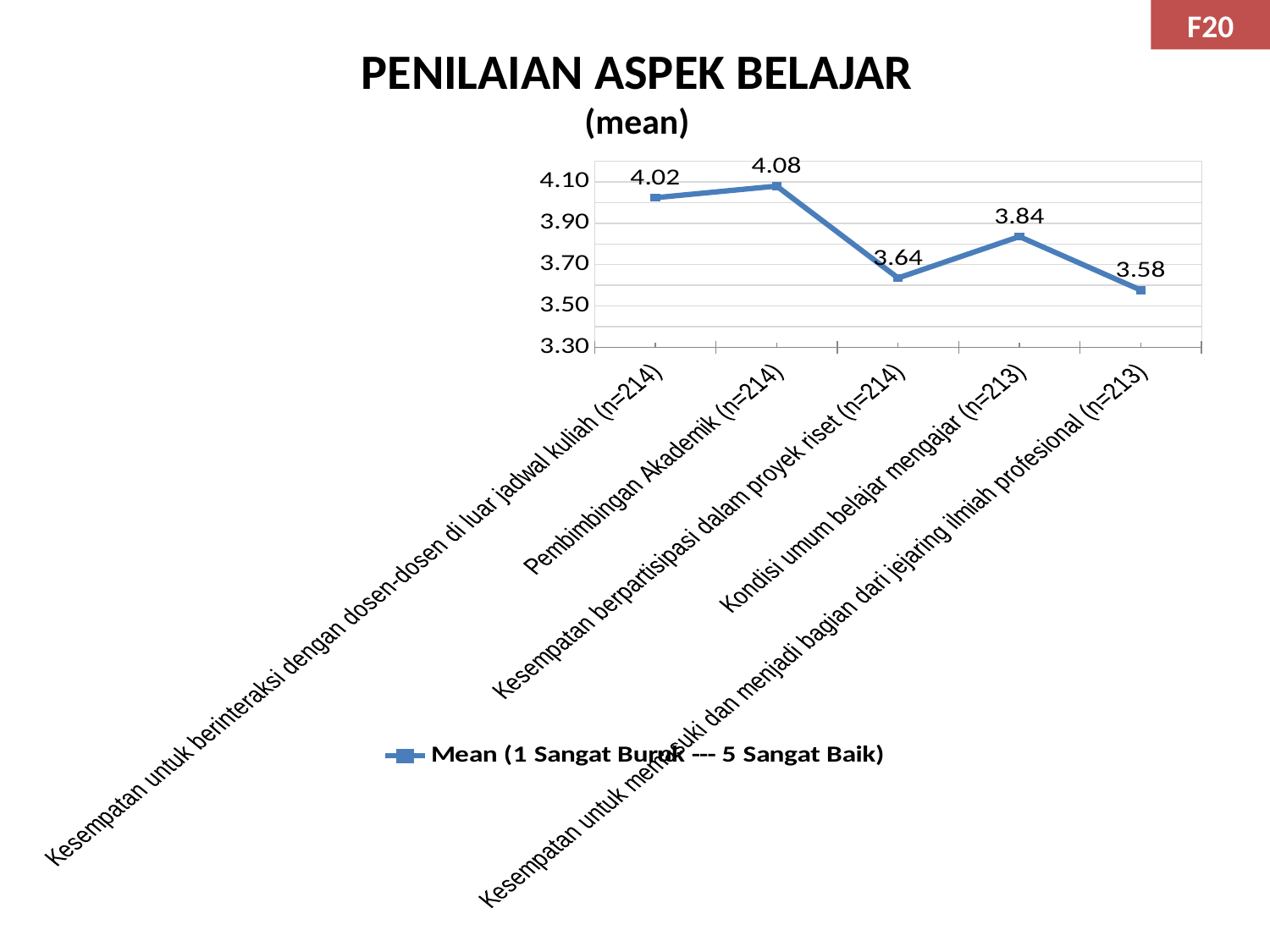
What is the legend entry for the plotted series? Mean (1 Sangat Buruk --- 5 Sangat Baik) Which has a higher mean: Kondisi umum belajar mengajar (n=213) or Kesempatan berpartisipasi dalam proyek riset (n=214)? Kondisi umum belajar mengajar (n=213) What is the difference between the mean for Pembimbingan Akademik (n=214) and the mean for Kesempatan berpartisipasi dalam proyek riset (n=214)? 0.44 What kind of chart is shown on the slide? Line chart Is the mean value for Kesempatan untuk berinteraksi dengan dosen-dosen di luar jadwal kuliah (n=214) greater or less than 3.90? greater How many series does the legend list? 1 What is the mean value for Kesempatan berpartisipasi dalam proyek riset (n=214)? 3.64 Which category has the lowest mean value? Kesempatan untuk memasuki dan menjadi bagian dari jejaring ilmiah profesional (n=213) Which category has the highest mean value? Pembimbingan Akademik (n=214) How many categories are plotted on the chart? 5 What is the mean value for Kondisi umum belajar mengajar (n=213)? 3.84 What is the mean value for Pembimbingan Akademik (n=214)? 4.08